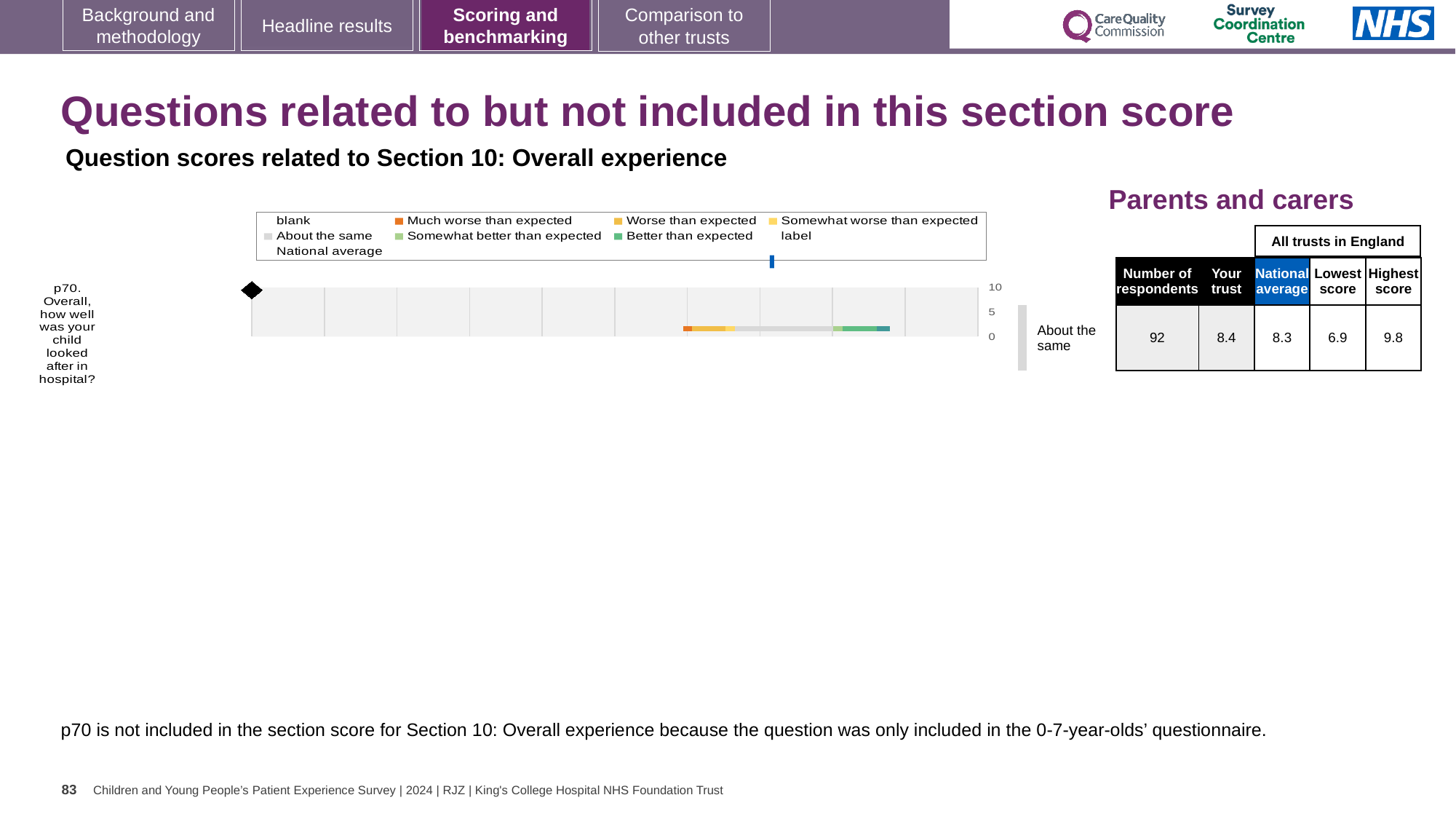
How many questions are plotted in the chart? 1 What is the difference between the highest and lowest scores for p70 across all trusts in England? 2.9 Which question is plotted in the chart? p70. Overall, how well was your child looked after in hospital? What is the lowest score among all trusts in England for p70? 6.9 What is the highest score among all trusts in England for p70? 9.8 What is the national average score for p70? 8.3 Which is larger for p70, the 'Your trust' score or the national average? Your trust What is the benchmark category shown to the right of the p70 bar? About the same What is the 'Your trust' score for p70 in the Parents and carers table? 8.4 What kind of chart is shown for question p70? bar chart How many respondents answered p70? 92 Is the national average marker for p70 on the chart greater or less than 5? greater